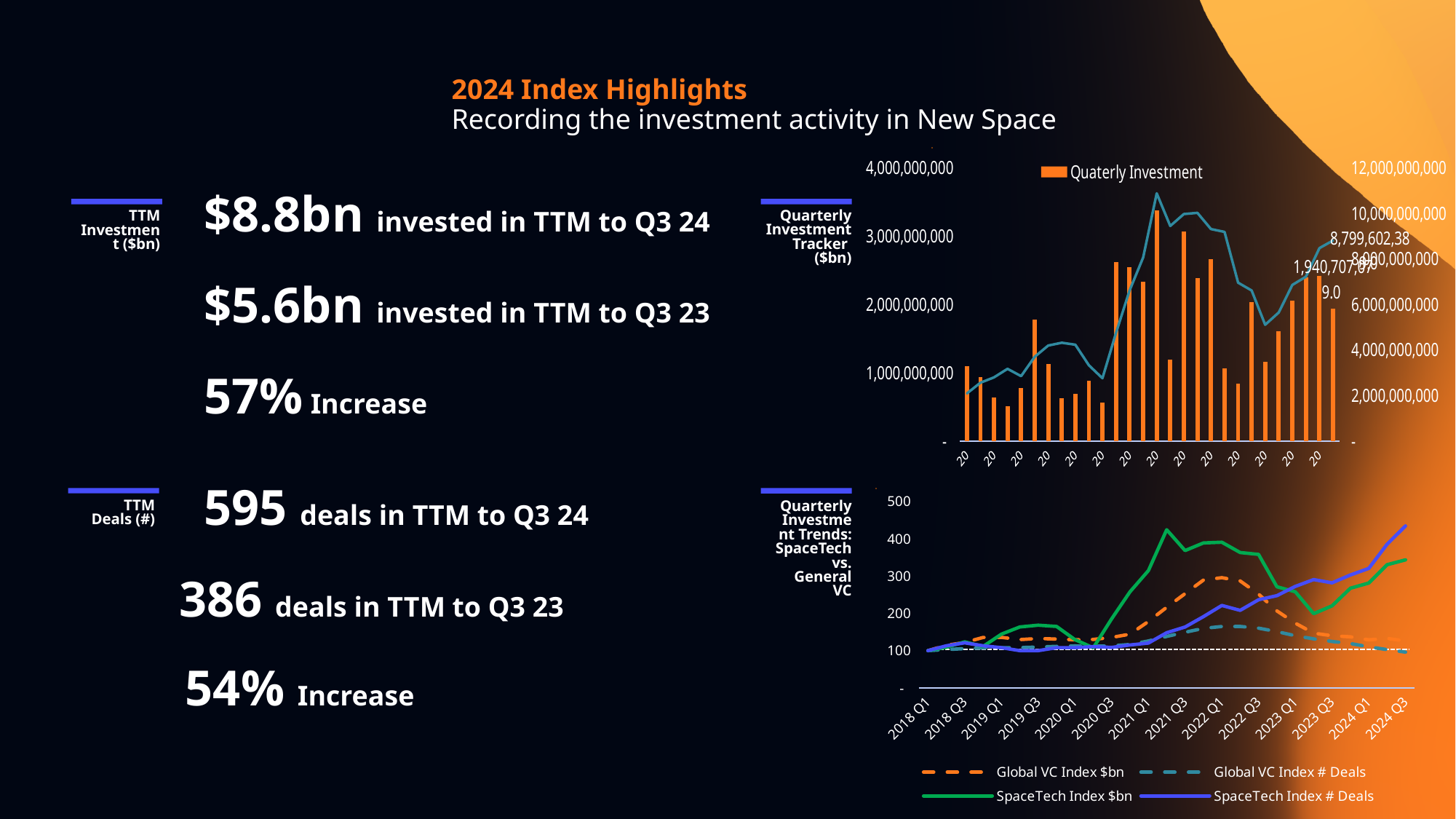
In the 'Quarterly Investment Trends: SpaceTech vs. General VC' chart, which is larger at 2024 Q3: SpaceTech Index $bn or Global VC Index $bn? SpaceTech Index $bn In the 'Quarterly Investment Trends: SpaceTech vs. General VC' chart, what colour is the SpaceTech Index $bn line? Green How many series does the legend of the 'Quarterly Investment Trends: SpaceTech vs. General VC' chart list? 4 In the 'Quarterly Investment Trends: SpaceTech vs. General VC' chart, is the value of SpaceTech Index # Deals at 2024 Q3 greater or less than 400? greater In the 'Quarterly Investment Trends: SpaceTech vs. General VC' chart, does the SpaceTech Index # Deals series rise or fall from 2023 Q1 to 2024 Q3? Rise In the 'Quarterly Investment Trends: SpaceTech vs. General VC' chart, is the value of Global VC Index # Deals at 2024 Q3 greater or less than 200? less In the 'Quarterly Investment Trends: SpaceTech vs. General VC' chart, which series has the highest value at 2024 Q3? SpaceTech Index # Deals What kind of chart is the 'Quarterly Investment Trends: SpaceTech vs. General VC' chart? Line chart What is the single legend entry shown on the 'Quarterly Investment Tracker ($bn)' chart? Quaterly Investment In the 'Quarterly Investment Tracker ($bn)' chart, is the tallest bar greater or less than 3,000,000,000 on the left axis? greater How many x-axis labels are shown on the 'Quarterly Investment Trends: SpaceTech vs. General VC' chart? 14 In the 'Quarterly Investment Trends: SpaceTech vs. General VC' chart, does the Global VC Index # Deals series rise or fall from 2022 Q3 to 2024 Q3? Fall